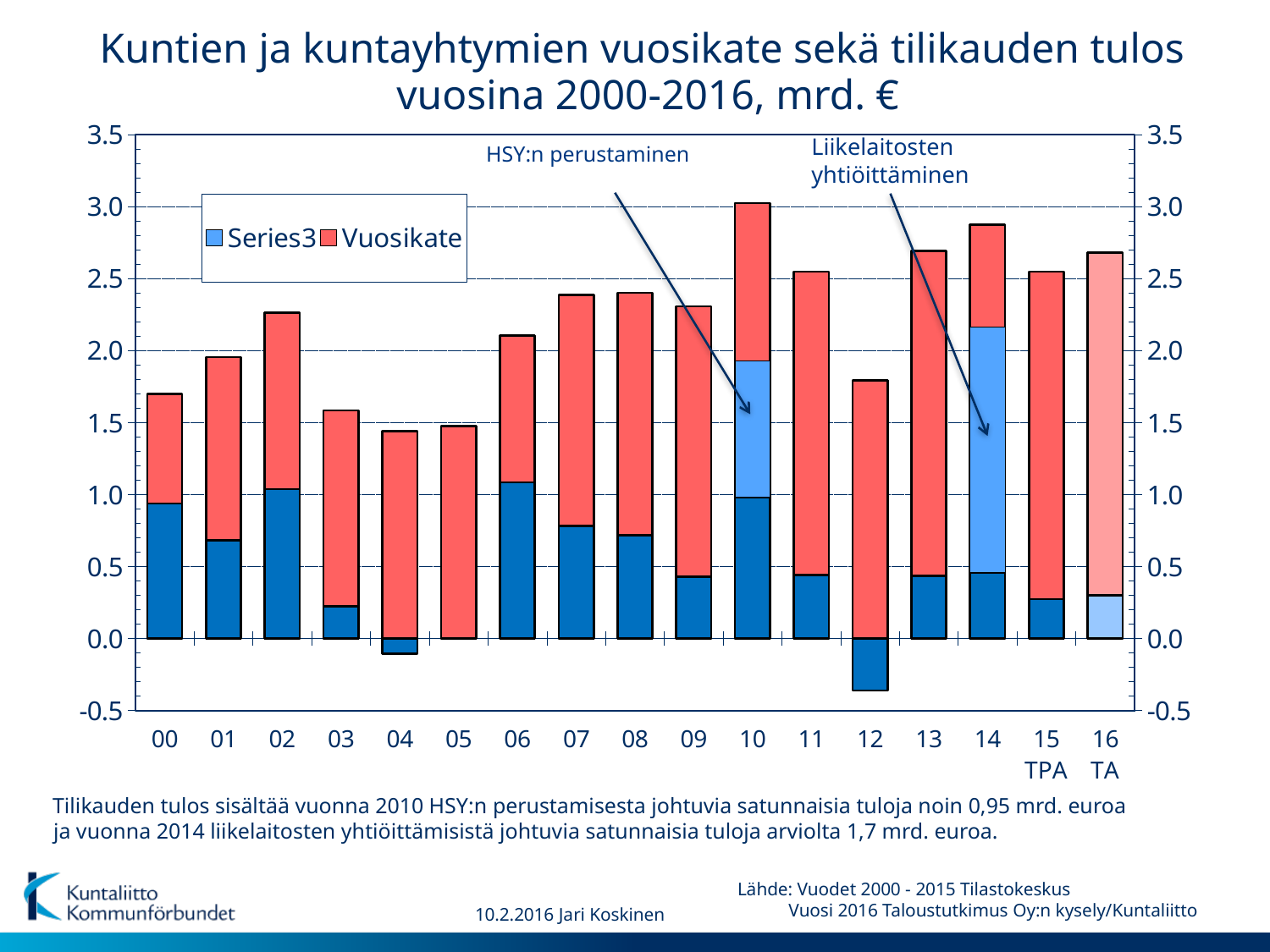
Do the total bar heights rise or fall from year 04 to year 07? rise Is the total bar height for year 00 greater or less than 2.0? less Is the Series3 value for year 12 greater or less than 0.0? less How many years (categories) are shown on the x axis? 17 Which year has a taller total bar, 10 or 11? 10 Is the total bar height for year 02 greater or less than 2.0? greater Which year has the tallest bar overall? 10 How many series does the legend list? 2 Which year has a taller total bar, 01 or 02? 02 What are the two entries listed in the legend? Series3 and Vuosikate What kind of chart is shown on the slide? bar chart